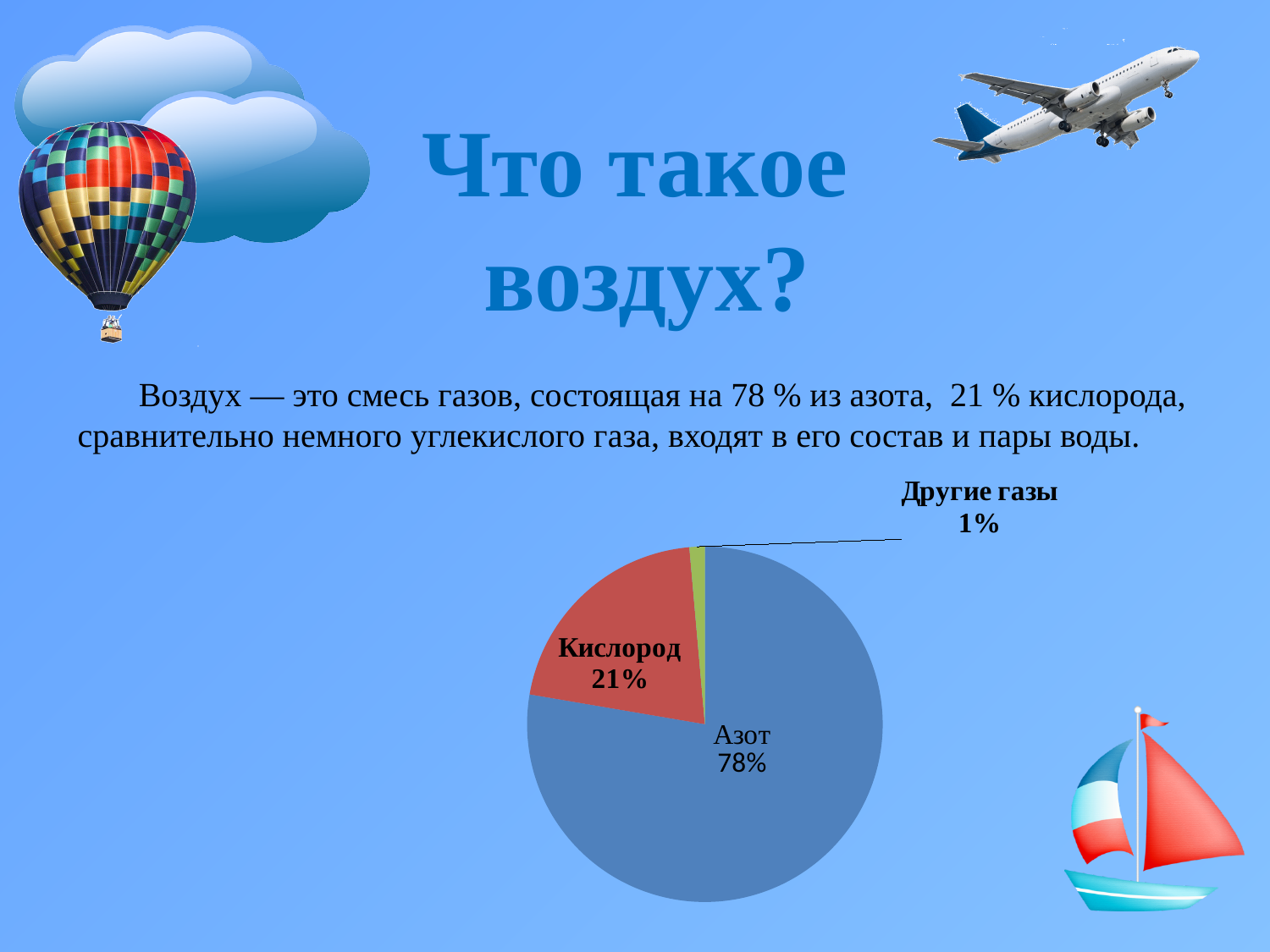
How many slices does the pie chart have? 3 What is the difference between the shares of Азот and Кислород? 57% Which slice of the pie is the smallest? Другие газы What colour is the Кислород slice? Red What share of the pie does Азот (nitrogen) take? 78% What kind of chart is shown on the slide? Pie chart Which is larger, the share of Кислород or the share of Другие газы? Кислород Which slice of the pie is the largest? Азот What share of the pie does Кислород (oxygen) take? 21% What is the combined share of Кислород and Другие газы? 22% What colour is the Азот slice? Blue What share of the pie does Другие газы (other gases) take? 1%